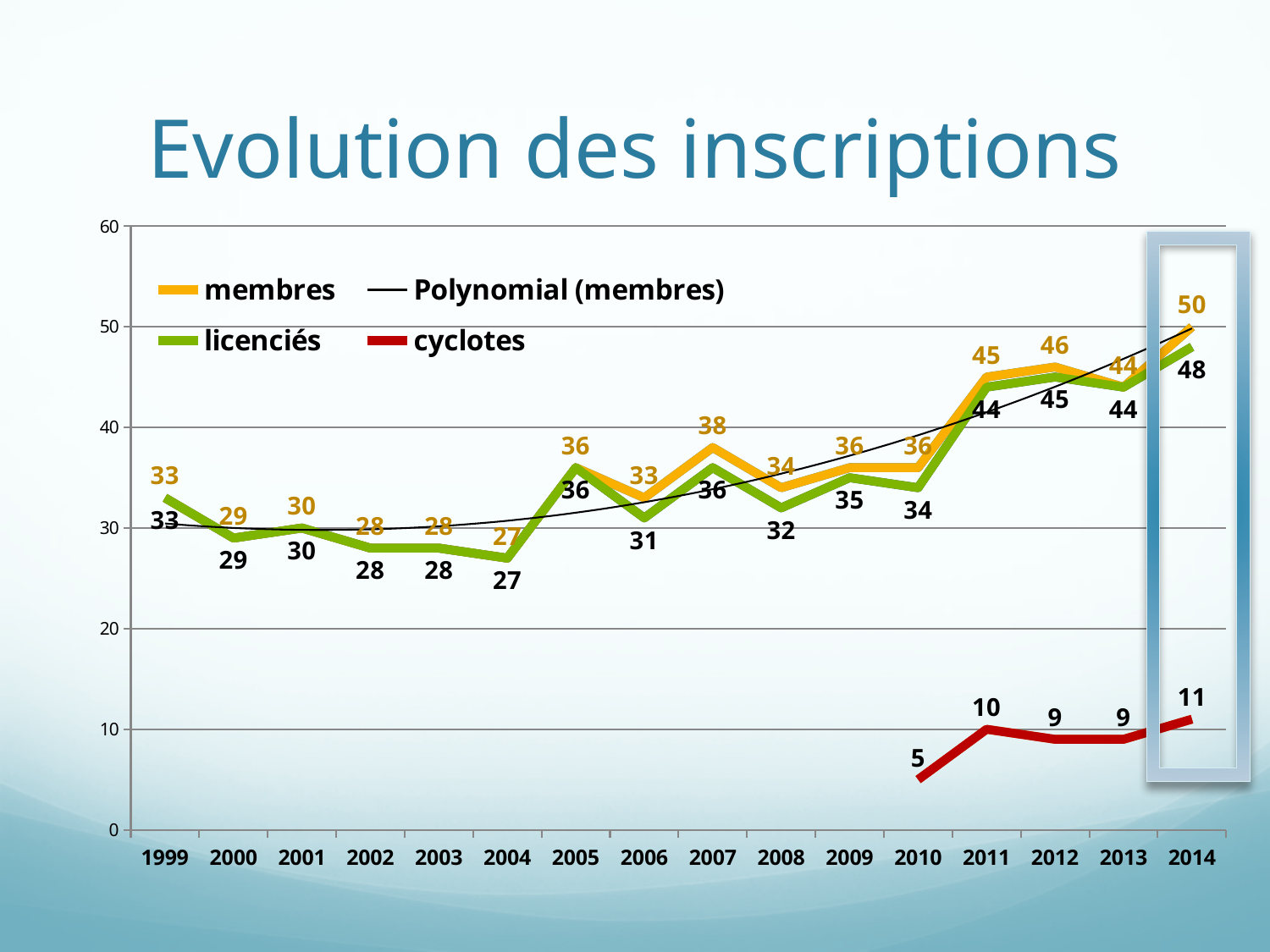
What is the value of membres in 2014? 50 What is the value of licenciés in 2006? 31 Does the cyclotes series rise or fall from 2010 to 2011? rise What type of chart is shown on the slide? line chart What is the difference between membres and licenciés in 2007? 2 How many entries does the legend list? 4 What is the value of cyclotes in 2010? 5 What is the title of the chart? Evolution des inscriptions How many years are shown on the x axis? 16 In which year is the membres series at its lowest? 2004 In which year is the licenciés series at its highest? 2014 Which is larger in 2008, membres or licenciés? membres